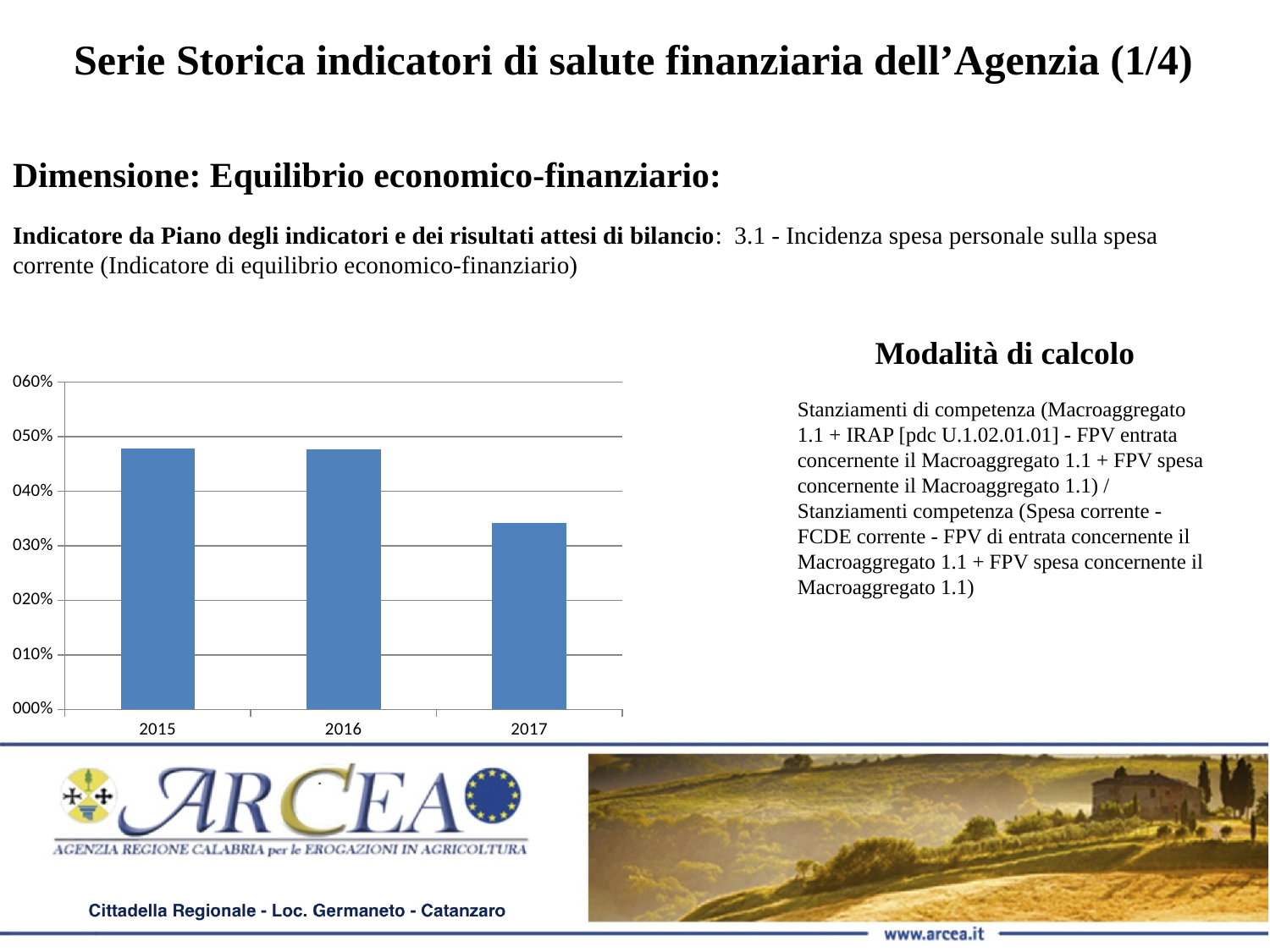
Is the value for 2015 greater or less than 40%? greater Is the value for 2017 greater or less than 40%? less Do the values rise or fall from 2016 to 2017? fall What colour are the bars in the chart? blue Is the value for 2015 greater or less than 50%? less Which is larger, the value for 2016 or the value for 2017? 2016 What is the highest tick shown on the vertical axis of the chart? 060% How many years are plotted on the x axis of the chart? 3 What kind of chart is shown on the slide? bar chart Which year has the lowest value in the chart? 2017